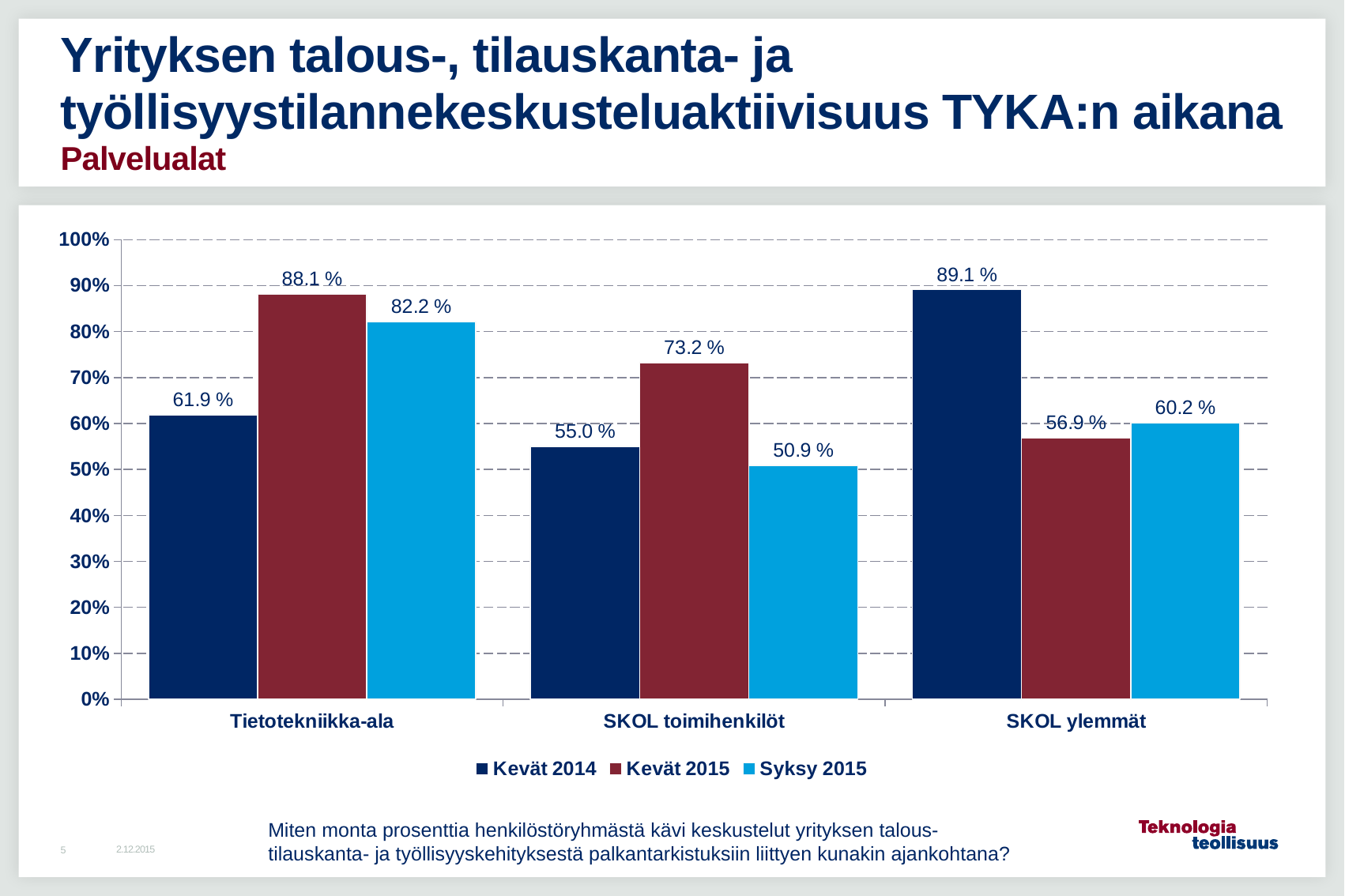
How many categories are shown on the x axis? 3 What is the difference between the Kevät 2015 and Kevät 2014 values for Tietotekniikka-ala? 26.2 % What kind of chart is shown on the slide? bar chart Which category has the lowest Syksy 2015 value? SKOL toimihenkilöt Is the Kevät 2014 value for SKOL toimihenkilöt greater or less than 60%? less What is the value for Syksy 2015 in the SKOL toimihenkilöt category? 50.9 % What is the value for Kevät 2014 in the SKOL ylemmät category? 89.1 % What is the value for Kevät 2015 in the Tietotekniikka-ala category? 88.1 % Which category has the highest Kevät 2014 value? SKOL ylemmät How many series does the legend list? 3 Which is larger for SKOL ylemmät: the Kevät 2015 value or the Syksy 2015 value? Syksy 2015 Which series is shown in light blue in the legend? Syksy 2015